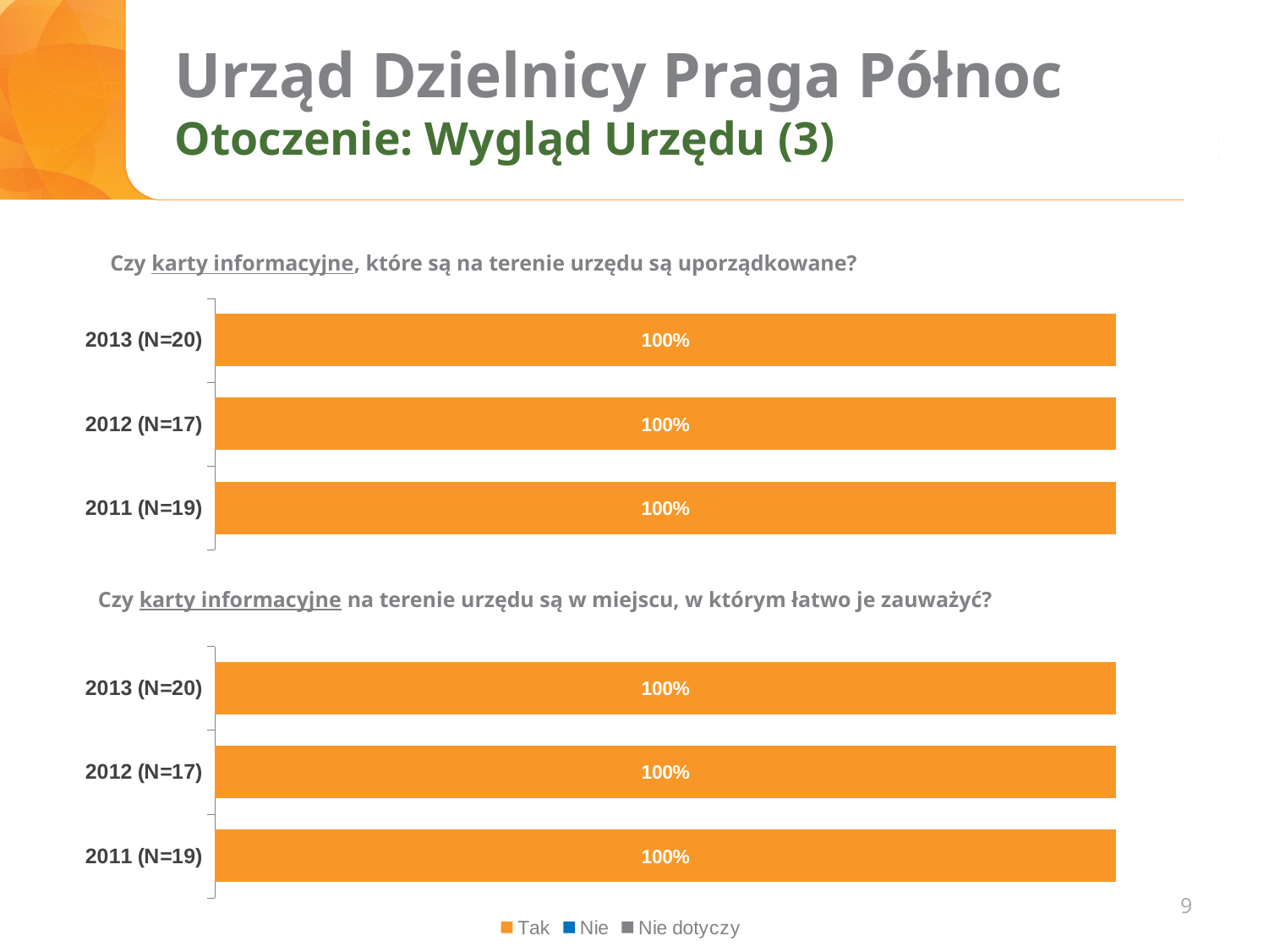
How many categories (years) are shown in the bottom chart? 3 In the bottom chart, what is the value for 2013 (N=20)? 100% In the top chart, what is the difference between the values for 2013 (N=20) and 2011 (N=19)? 0% In the top chart, what is the value for 2013 (N=20)? 100% What is the sample size (N) shown for 2012 in the bottom chart? N=17 In the bottom chart, what is the difference between the values for 2012 (N=17) and 2011 (N=19)? 0% In the top chart, what is the value for 2011 (N=19)? 100% What kind of chart is the top chart? Bar chart In the bottom chart, what is the value for 2012 (N=17)? 100% How many categories (years) are shown in the top chart? 3 Which legend entry is shown in orange? Tak How many series does the legend at the bottom of the slide list? 3